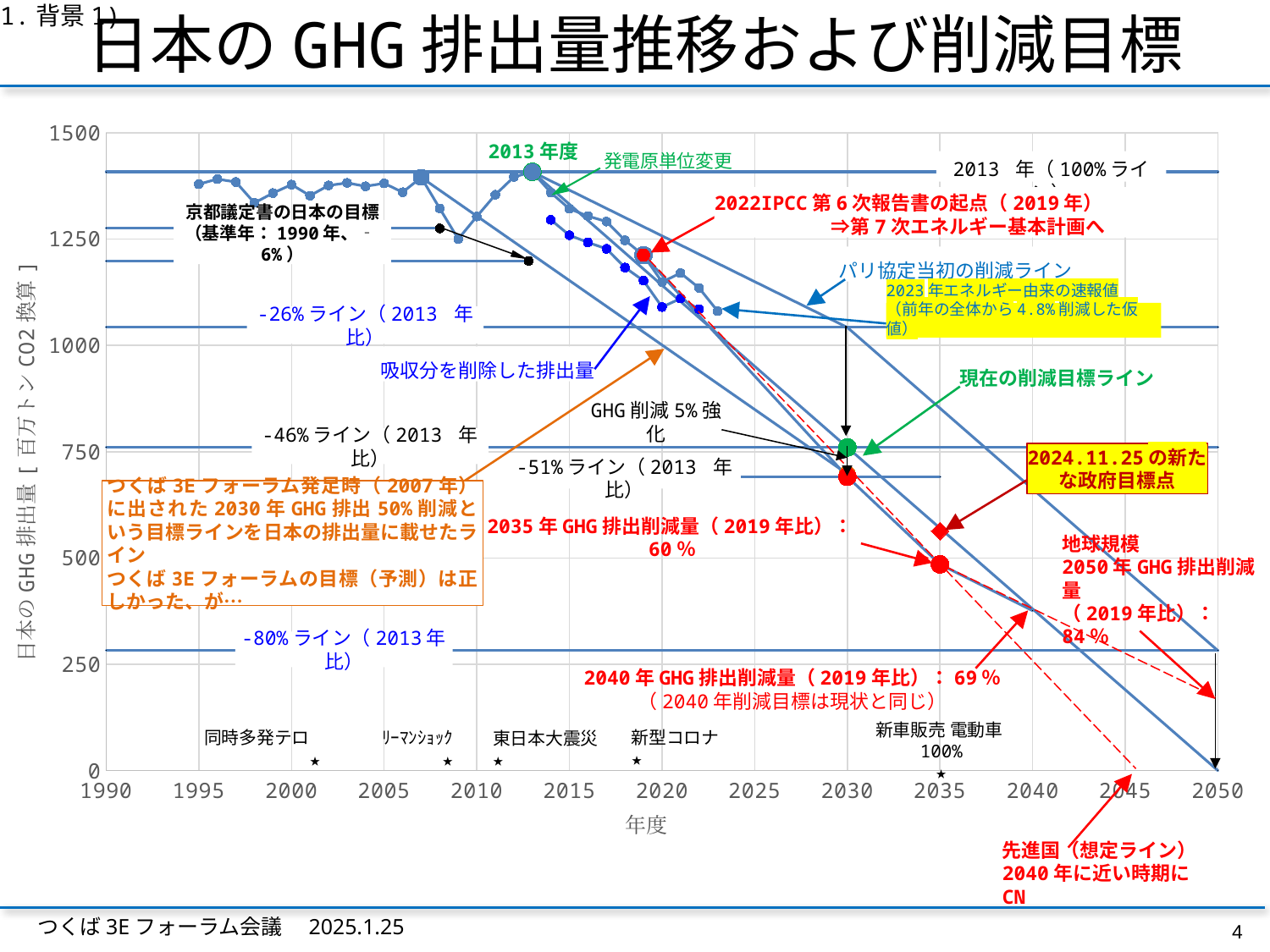
What is the label of the y axis of the chart? 日本のGHG排出量[百万トンCO2換算] Do Japan's actual emissions rise or fall between 2013 and 2023? fall According to the annotation, what is the global 2050 GHG emission reduction target relative to 2019? 84% What kind of chart is shown on the slide? line chart According to the annotation, what is the 2035 GHG emission reduction target relative to 2019? 60% Is the emission value at the 2019 starting point (2022IPCC第6次報告書の起点) greater or less than 1000? greater What is the highest value shown on the y axis of the chart? 1500 According to the annotation, by what percentage did the 2023 energy-derived preliminary value fall from the previous year's total? 4.8% What is the label of the x axis of the chart? 年度 What reduction percentage relative to 2013 does the lowest horizontal reference line represent? -80% Is the emission value for 2013 (the peak marked 2013年度) greater or less than 1250? greater According to the annotation, what is the 2040 GHG emission reduction target relative to 2019? 69%